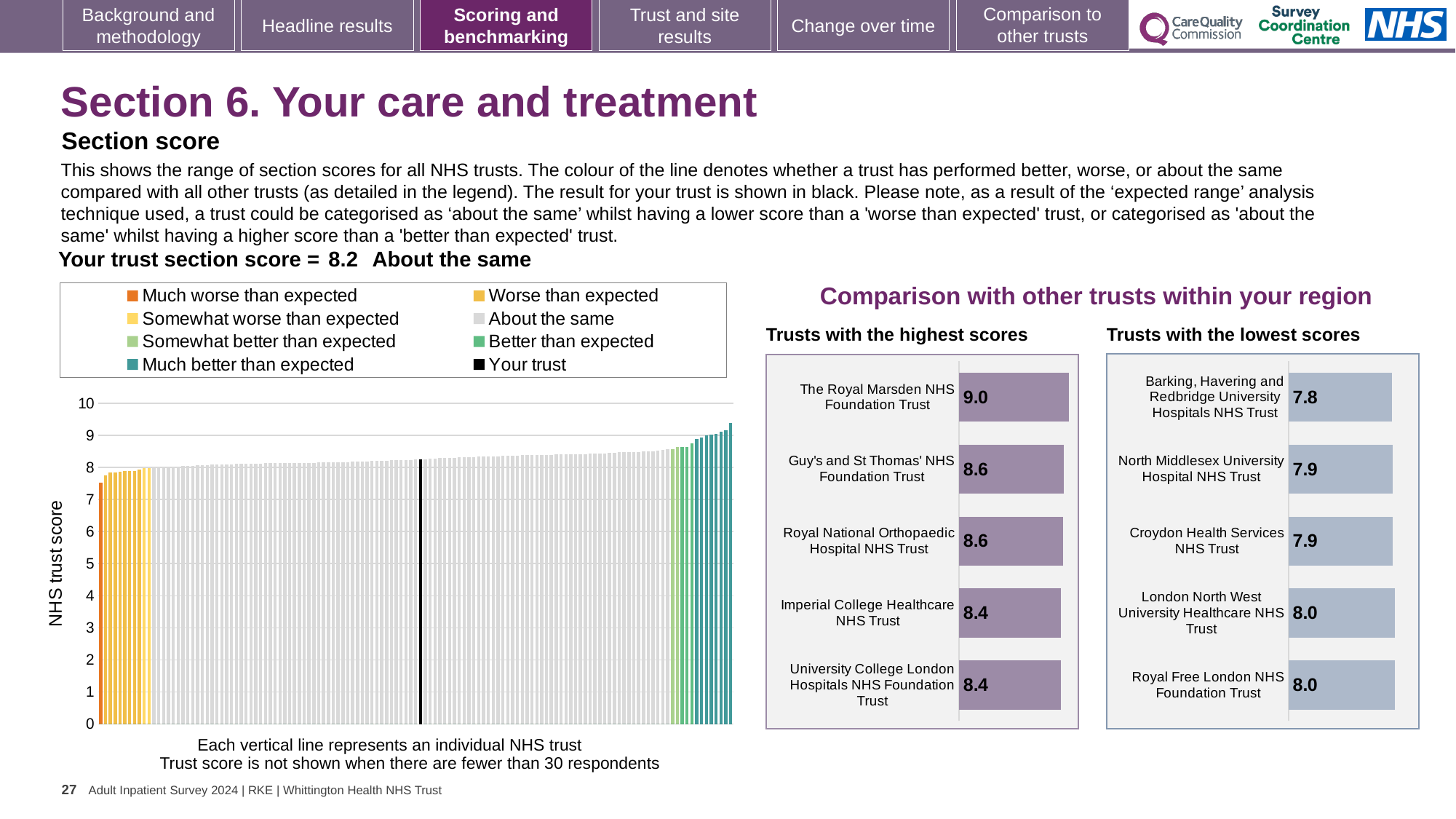
In the 'Trusts with the highest scores' chart, which trust has the highest score? The Royal Marsden NHS Foundation Trust How many trusts are shown in the 'Trusts with the lowest scores' chart? 5 In the 'Trusts with the lowest scores' chart, which trust has the lowest score? Barking, Havering and Redbridge University Hospitals NHS Trust What kind of chart is the main NHS trust score chart on the left of the slide? Bar chart In the 'Trusts with the lowest scores' chart, what is the difference between the scores of Royal Free London NHS Foundation Trust and Barking, Havering and Redbridge University Hospitals NHS Trust? 0.2 In the main NHS trust score chart on the left, is the value of the tallest bar greater or less than 9? greater In the main NHS trust score chart on the left, do the bar values rise or fall from left to right? Rise How many entries does the legend of the main NHS trust score chart on the left list? 8 In the 'Trusts with the lowest scores' chart, what is the score for Barking, Havering and Redbridge University Hospitals NHS Trust? 7.8 In the 'Trusts with the highest scores' chart, what is the difference between the scores of The Royal Marsden NHS Foundation Trust and Imperial College Healthcare NHS Trust? 0.6 Which is larger: the score for Guy's and St Thomas' NHS Foundation Trust in the highest scores chart, or the score for North Middlesex University Hospital NHS Trust in the lowest scores chart? Guy's and St Thomas' NHS Foundation Trust In the 'Trusts with the highest scores' chart, what is the score for The Royal Marsden NHS Foundation Trust? 9.0